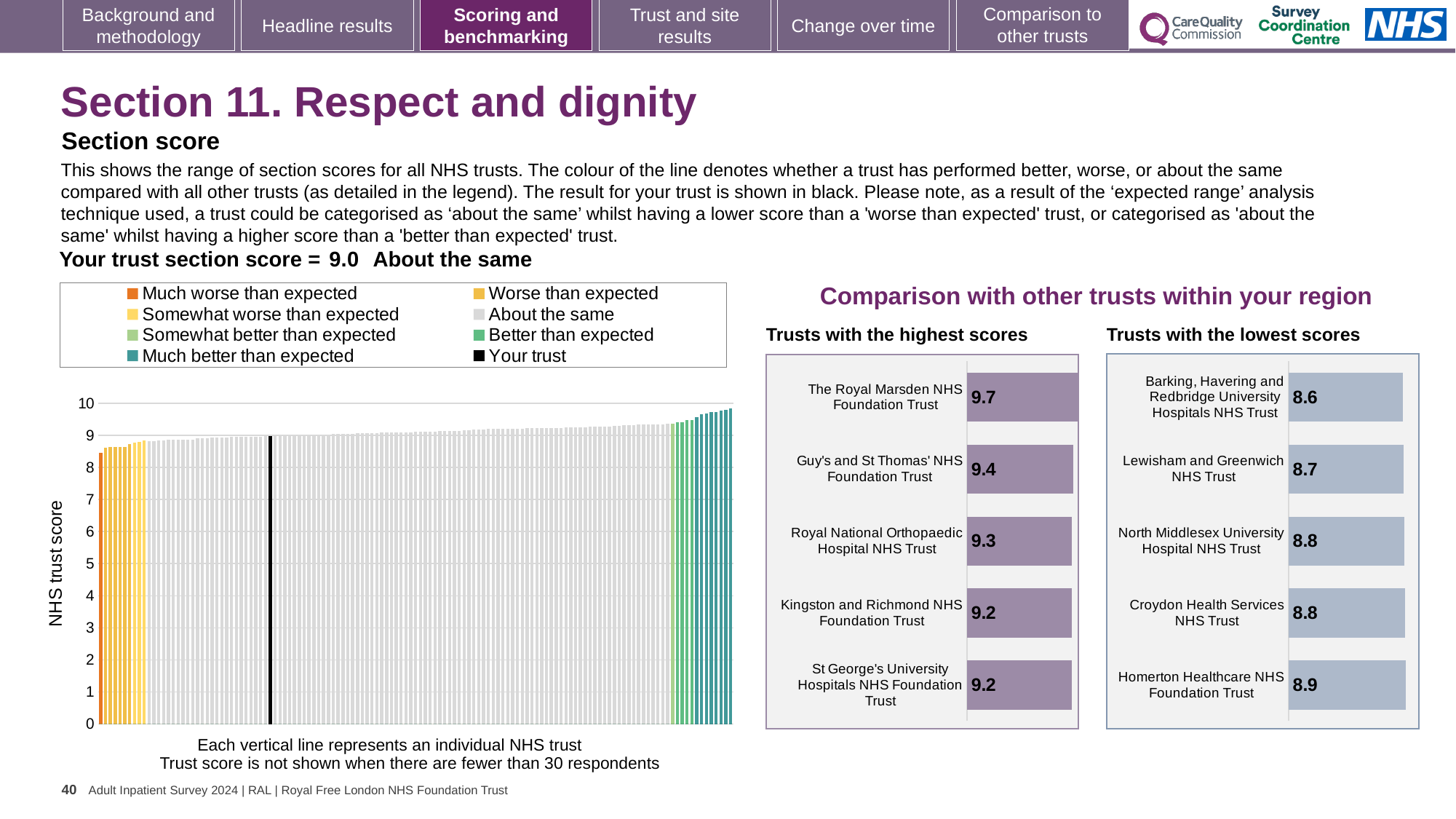
In the 'Trusts with the highest scores' chart, what is the difference between the scores of The Royal Marsden NHS Foundation Trust and Guy's and St Thomas' NHS Foundation Trust? 0.3 In the 'Trusts with the lowest scores' chart, which has the larger score: Lewisham and Greenwich NHS Trust or Homerton Healthcare NHS Foundation Trust? Homerton Healthcare NHS Foundation Trust In the 'Trusts with the highest scores' chart, what is the score for Royal National Orthopaedic Hospital NHS Trust? 9.3 In the 'Trusts with the lowest scores' chart, which trust has the lowest score? Barking, Havering and Redbridge University Hospitals NHS Trust In the 'Trusts with the lowest scores' chart, what is the score for Lewisham and Greenwich NHS Trust? 8.7 In the large chart on the left showing all NHS trusts, what kind of chart is it? Bar chart In the 'Trusts with the highest scores' chart, what is the score for The Royal Marsden NHS Foundation Trust? 9.7 In the 'Trusts with the highest scores' chart, how many trusts are listed? 5 In the large chart on the left showing all NHS trusts, do the trust scores rise or fall from left to right? Rise In the 'Trusts with the highest scores' chart, which trust has the highest score? The Royal Marsden NHS Foundation Trust In the large chart on the left showing all NHS trusts, how many entries does the legend list? 8 In the 'Trusts with the lowest scores' chart, what is the difference between the scores of Homerton Healthcare NHS Foundation Trust and Barking, Havering and Redbridge University Hospitals NHS Trust? 0.3